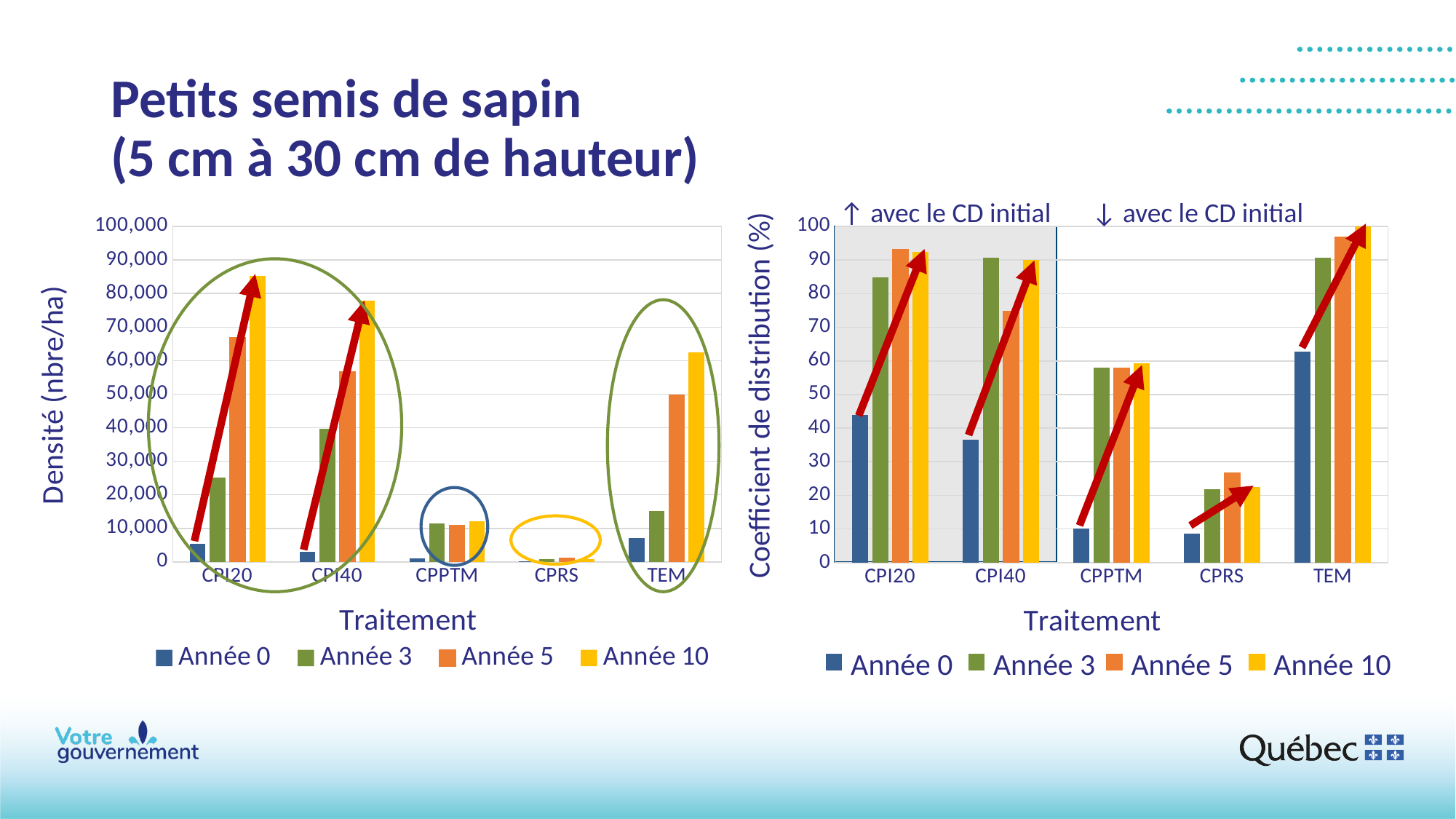
In the left chart (Densité), which treatment has the highest Année 10 value? CPI20 In the right chart (Coefficient de distribution), which treatment has the highest Année 10 value? TEM In the left chart (Densité), which treatment has the lowest Année 10 value? CPRS What is the y-axis label of the right chart? Coefficient de distribution (%) In the left chart (Densité), do the values for CPI20 rise or fall from Année 0 to Année 10? rise How many treatment categories are shown on the x axis of the left chart (Densité)? 5 How many series does the legend of the right chart (Coefficient de distribution) list? 4 In the left chart (Densité), is the Année 3 value for CPI20 greater or less than 20,000? greater In the right chart (Coefficient de distribution), is the Année 0 value for CPI40 greater or less than 40? less What kind of chart is the left chart (Densité)? bar chart In the right chart (Coefficient de distribution), which is larger: the Année 5 value for CPI20 or for CPI40? CPI20 In the left chart (Densité), is the Année 5 value for CPI20 greater or less than 60,000? greater